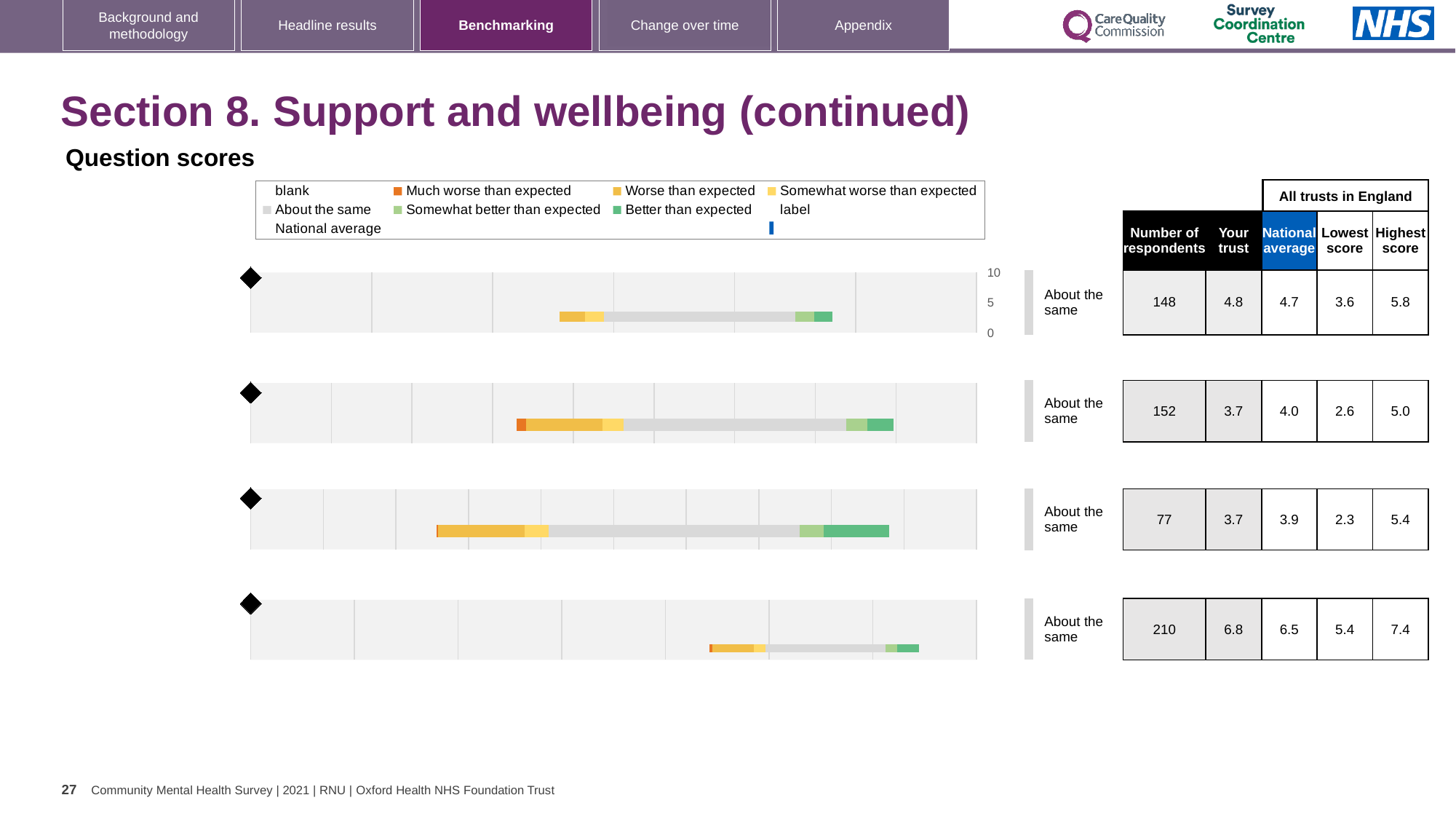
How many question score charts are shown on the slide? 4 For the first (top) chart, what is the 'Your trust' score? 4.8 For the first (top) chart, how much higher is the 'Your trust' score than the national average? 0.1 For the fourth (bottom) chart, what is the number of respondents? 210 For the fourth (bottom) chart, what is the difference between the highest score and the lowest score across all trusts in England? 2.0 What benchmark category is shown next to each of the four charts? About the same For the third chart, what is the national average score? 3.9 What kind of chart is used to show the question scores on this slide? bar chart Which chart has the highest 'Your trust' score? the fourth (bottom) chart, 6.8 For the second chart, which is larger: the 'Your trust' score or the national average? the national average (4.0) Which chart has the lowest number of respondents? the third chart, 77 In the legend, what colour represents 'Much worse than expected'? orange